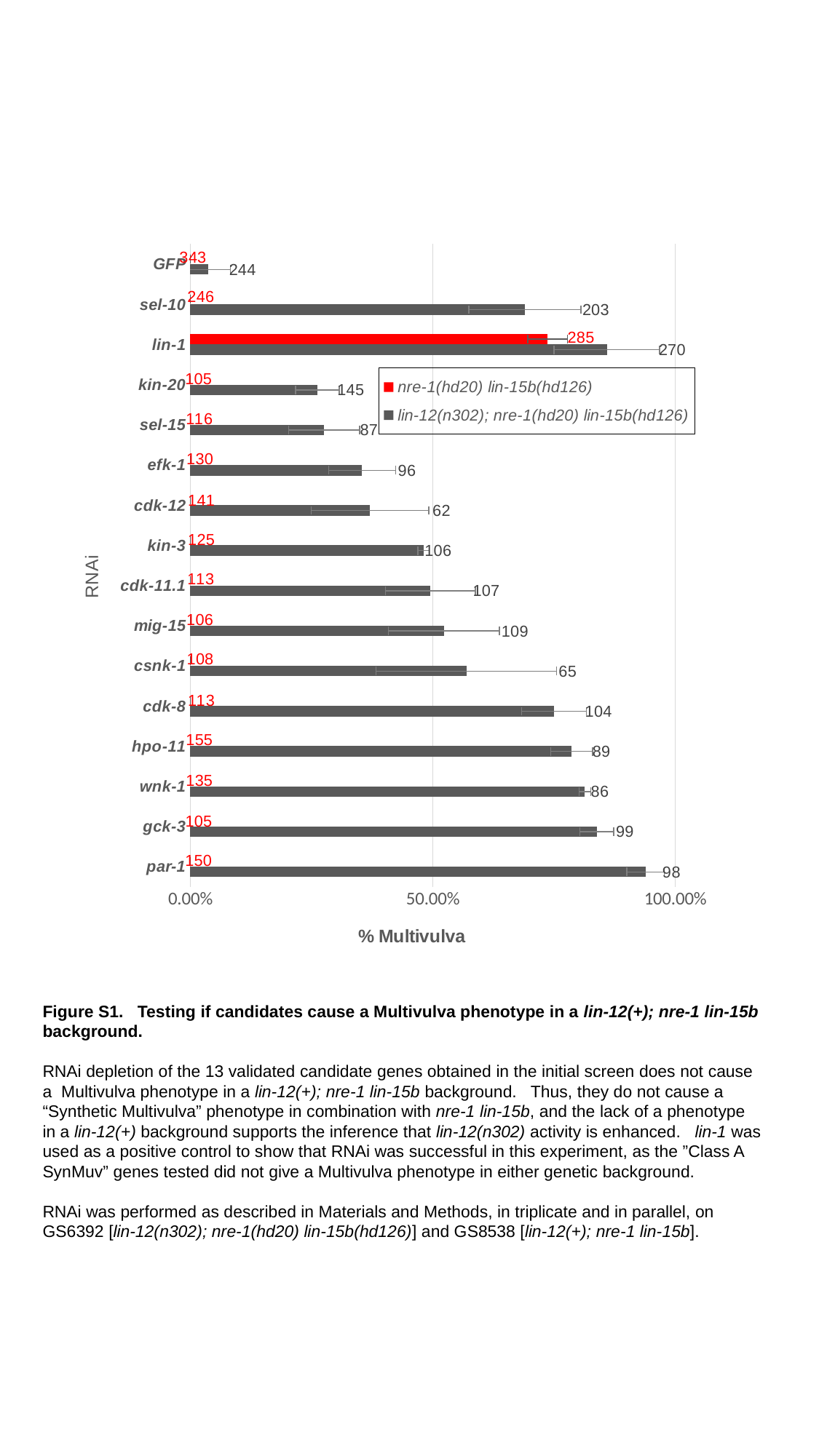
Is the red bar value for lin-1 greater or less than 50.00%? greater What kind of chart is shown on the slide? bar chart Is the grey bar value for cdk-12 greater or less than 50.00%? less For lin-1, which bar is longer: the red bar or the grey bar? the grey bar Which RNAi category has the shortest grey (lin-12(n302); nre-1(hd20) lin-15b(hd126)) bar? GFP What is the title of the horizontal axis of the chart? % Multivulva Is the grey bar value for kin-20 greater or less than 50.00%? less How many series does the chart legend list? 2 Which RNAi category is the only one with a clearly visible red (nre-1(hd20) lin-15b(hd126)) bar? lin-1 How many RNAi categories are listed on the vertical axis of the chart? 16 Which RNAi category has the longest grey (lin-12(n302); nre-1(hd20) lin-15b(hd126)) bar? par-1